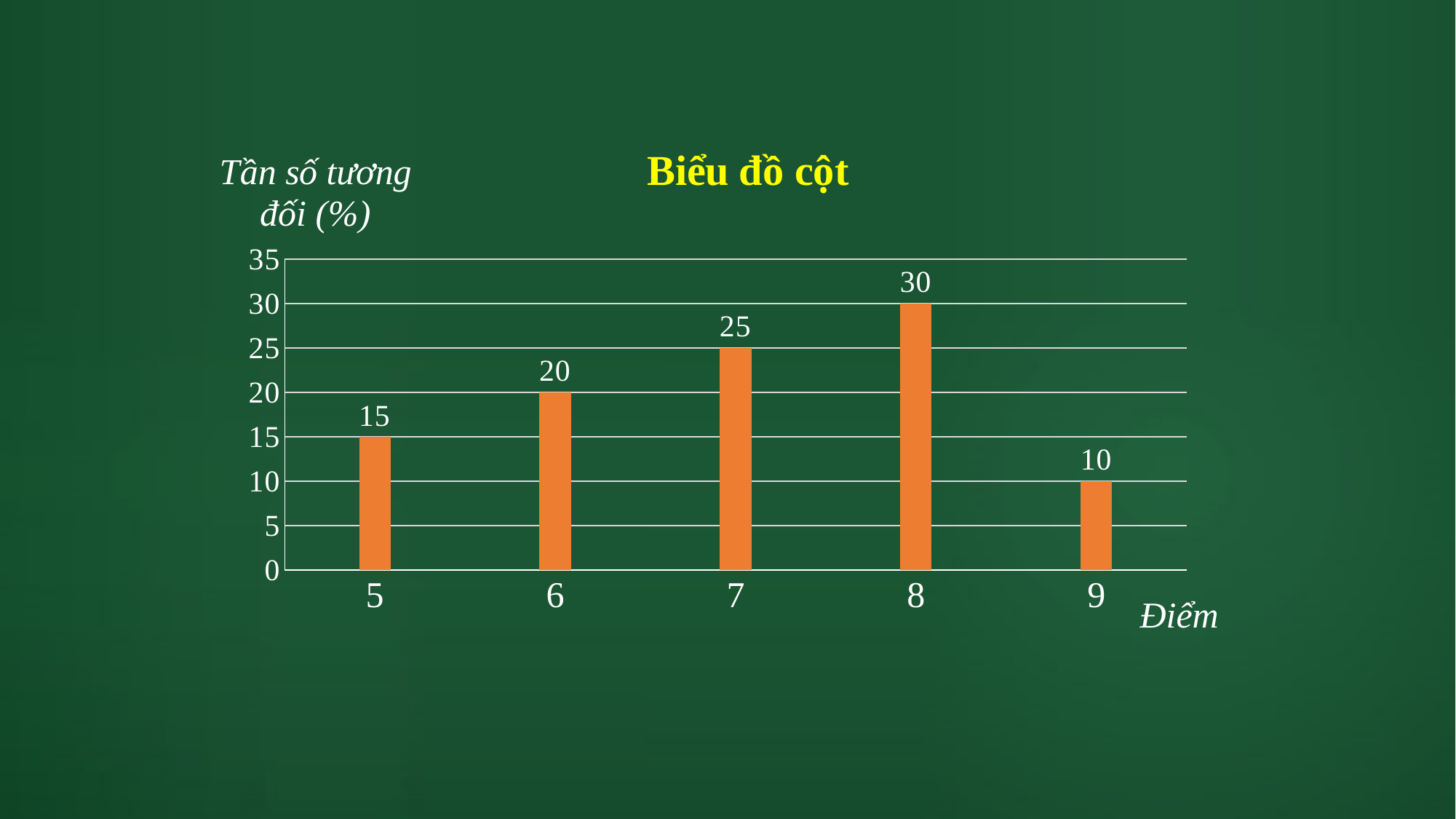
Which score has the highest relative frequency? 8 What is the title of the chart? Biểu đồ cột Which is larger, the value for score 6 or the value for score 9? 6 Which score has the lowest relative frequency? 9 What is the difference between the values for score 7 and score 9? 15 Is the value for score 8 greater or less than 25? greater How many score categories are shown on the x axis? 5 What is the value shown for score 5? 15 What is the value shown for score 9? 10 What is the difference between the values for score 8 and score 6? 10 What kind of chart is shown on the slide? bar chart What is the relative frequency (%) for score 7? 25